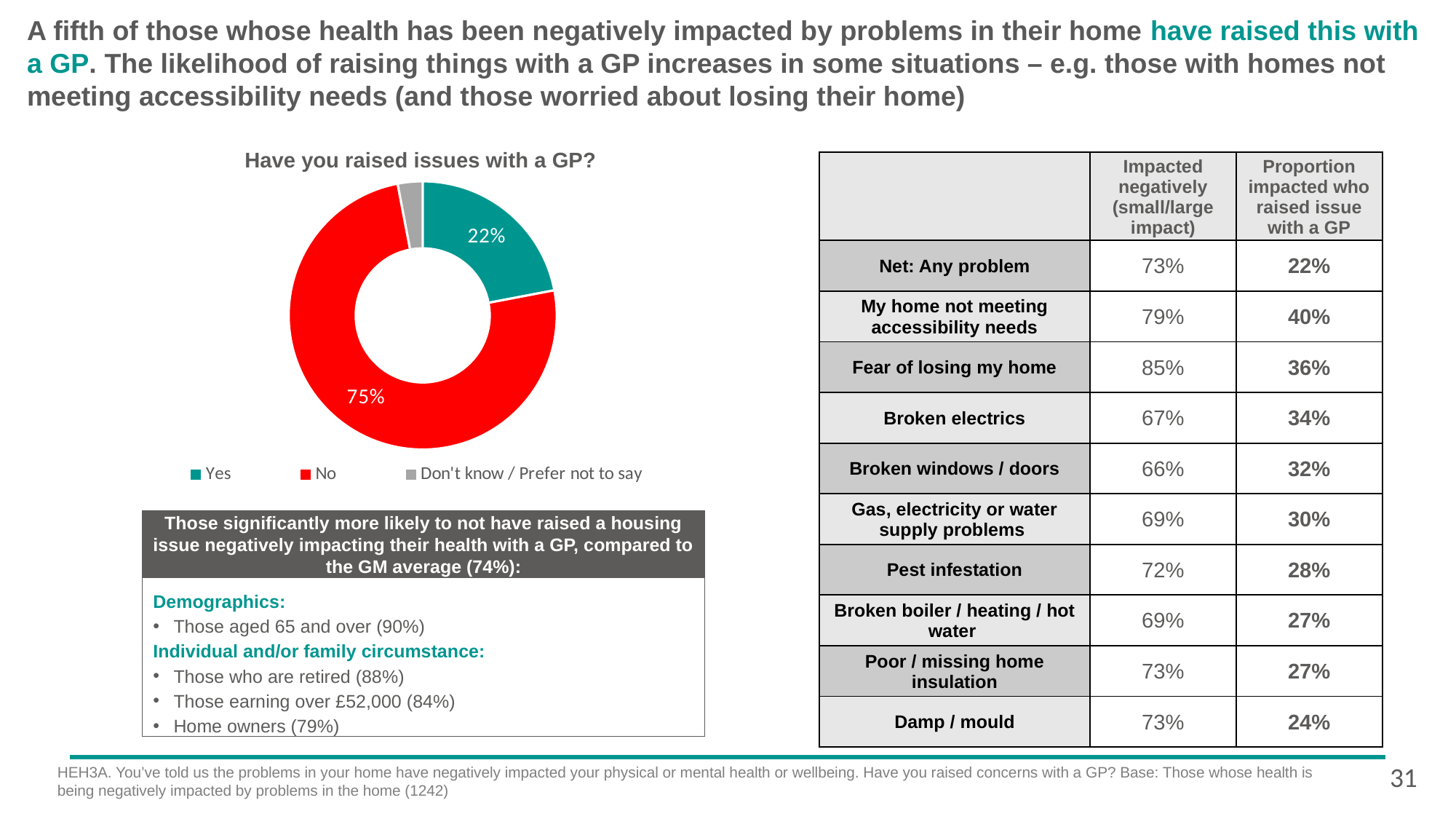
Which response has the largest share of the chart? No Which response has the smallest share of the chart? Don't know / Prefer not to say What is the title of the chart? Have you raised issues with a GP? Which is larger in the chart, the "Yes" slice or the "No" slice? No What colour is the "No" slice in the chart? Red What percentage of respondents answered "Yes" in the chart? 22% How many categories does the chart's legend list? 3 What is the difference in percentage points between the "No" and "Yes" slices? 53 percentage points Is the share for "Yes" greater or less than 50%? less Is the share for "No" greater or less than 50%? greater What percentage of respondents answered "No" in the chart? 75% What type of chart is shown on the slide? Pie chart (donut)